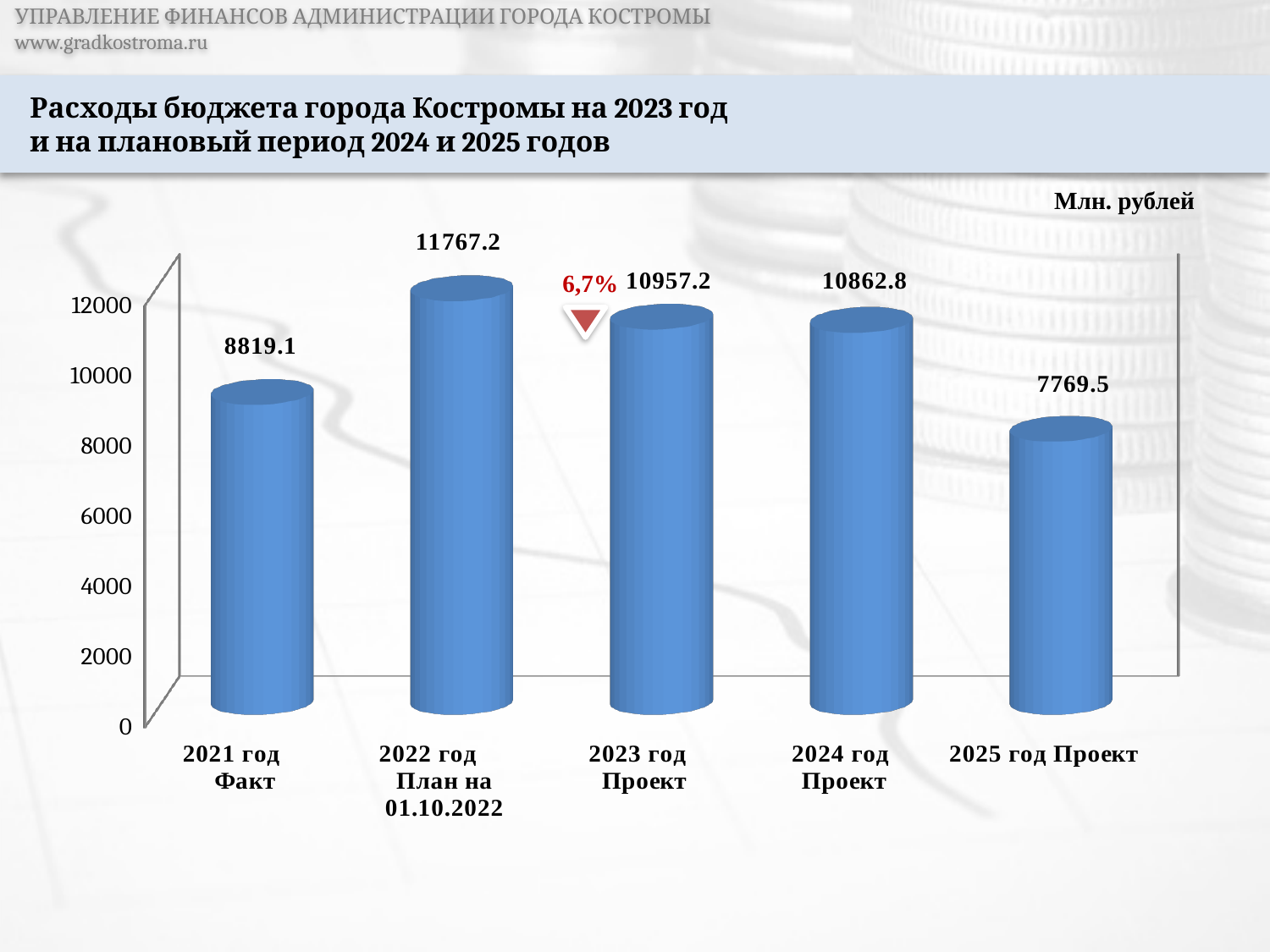
Which category has the lowest value? 2025 год Проект Is the value for 2024 год Проект greater or less than 10000? greater How many categories are shown on the chart? 5 What is the value for 2022 год План на 01.10.2022? 11767.2 Which category has the highest value? 2022 год План на 01.10.2022 What is the value for 2025 год Проект? 7769.5 What unit of measurement is indicated for the chart values? Млн. рублей What kind of chart is shown on the slide? bar chart What is the value for 2023 год Проект? 10957.2 What is the value for 2021 год Факт? 8819.1 What is the difference between the values for 2022 год План на 01.10.2022 and 2023 год Проект? 810.0 Which is larger, the value for 2021 год Факт or the value for 2025 год Проект? 2021 год Факт